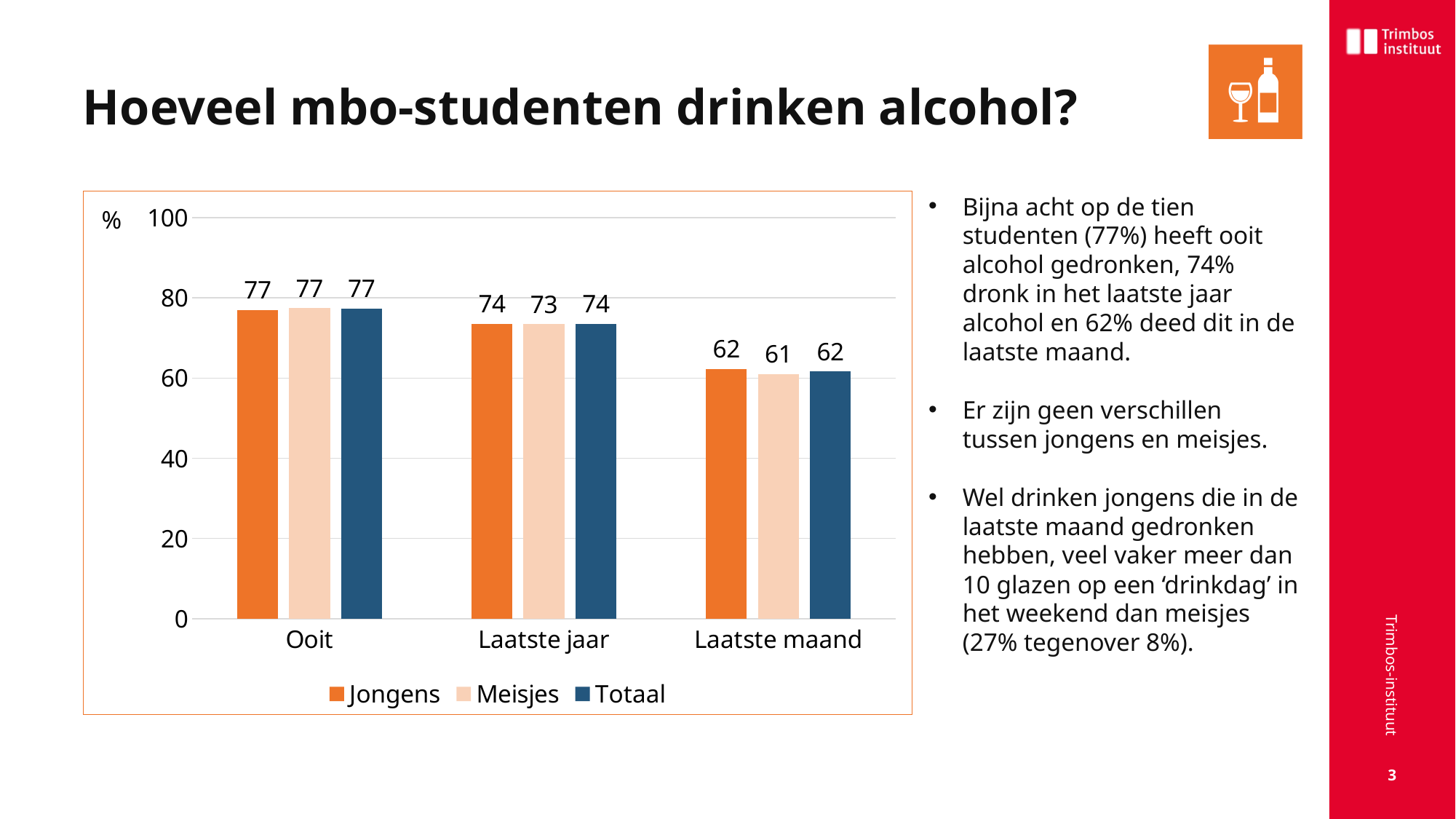
What is the value for Meisjes in the Laatste jaar category? 73 How many categories are shown on the x axis? 3 What is the value for Totaal in the Laatste maand category? 62 How many series does the legend list? 3 What is the value for Jongens in the Ooit category? 77 What is the value for Meisjes in the Laatste maand category? 61 What is the difference between the Totaal value for Ooit and the Totaal value for Laatste maand? 15 Which category has the highest value for Totaal? Ooit What kind of chart is shown on the slide? Bar chart Which is larger: the Jongens value for Laatste jaar or the Jongens value for Laatste maand? Laatste jaar Which category has the lowest value for Jongens? Laatste maand Do the Totaal values rise or fall from Ooit to Laatste maand? Fall